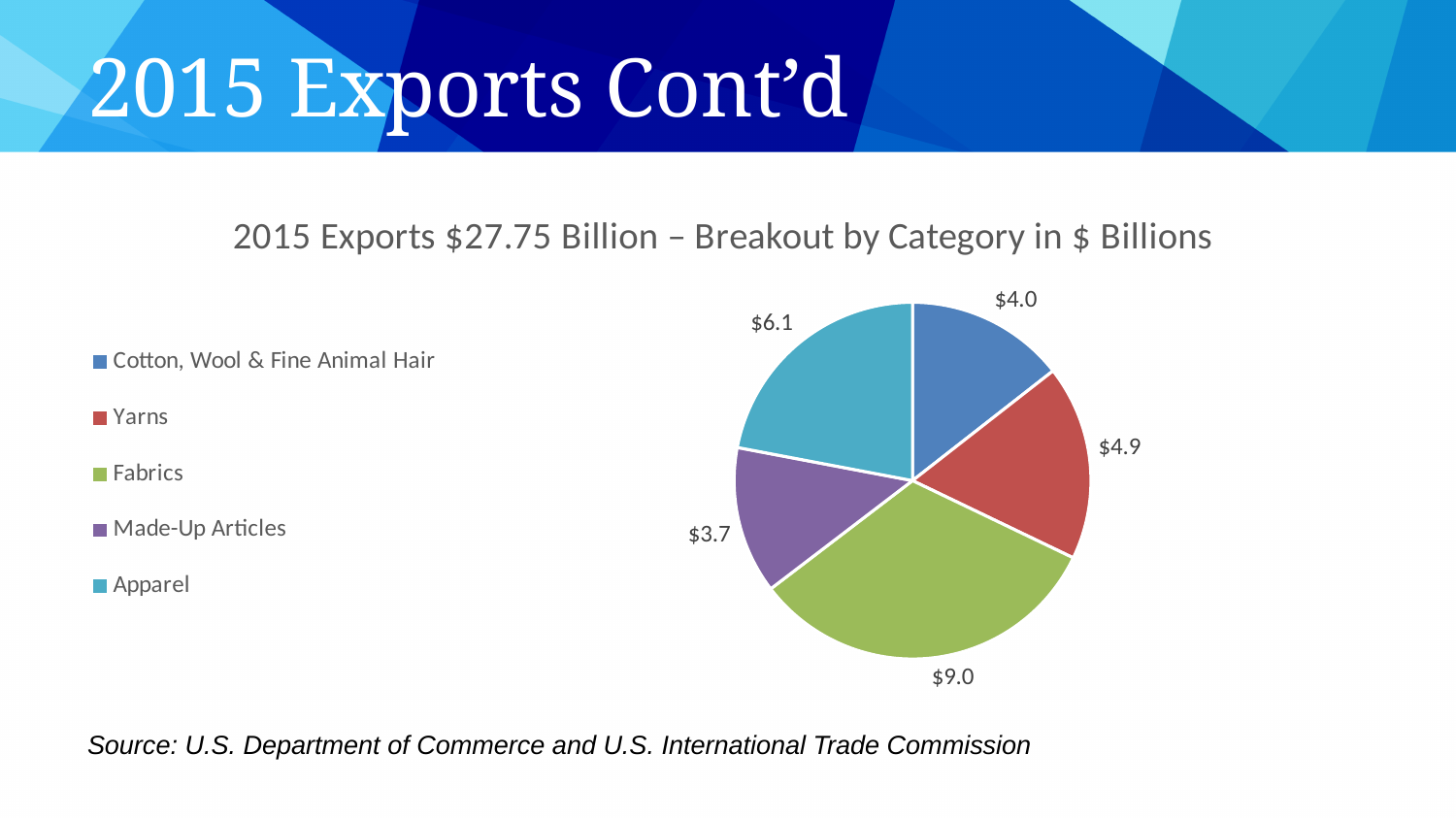
How many categories does the pie chart show? 5 What is the value for Apparel in the pie chart? $6.1 What is the value for Yarns in the pie chart? $4.9 What is the value for Cotton, Wool & Fine Animal Hair in the pie chart? $4.0 What is the difference between the values for Apparel and Cotton, Wool & Fine Animal Hair? $2.1 Which category has the largest slice of the pie chart? Fabrics What is the value for Made-Up Articles in the pie chart? $3.7 What is the difference between the values for Fabrics and Made-Up Articles? $5.3 What kind of chart is shown on the slide? Pie chart What is the value for Fabrics in the pie chart? $9.0 Which is larger, the value for Yarns or the value for Apparel? Apparel Which category has the smallest slice of the pie chart? Made-Up Articles